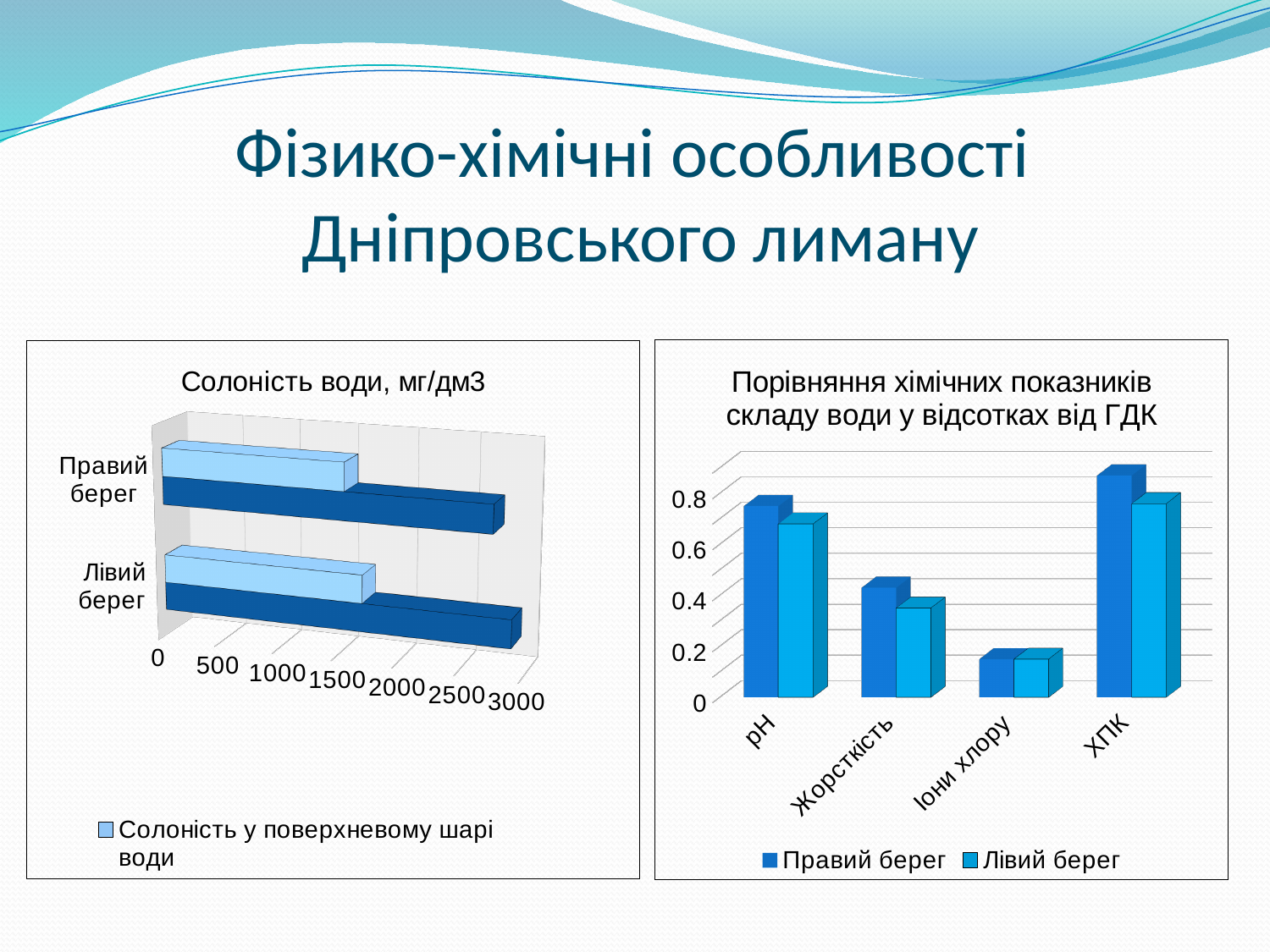
How many series does the legend of the right chart "Порівняння хімічних показників складу води у відсотках від ГДК" list? 2 On the right chart "Порівняння хімічних показників складу води у відсотках від ГДК", is the value of pH for Правий берег greater or less than 0.6? greater On the right chart "Порівняння хімічних показників складу води у відсотках від ГДК", which category has the highest value for Правий берег? ХПК On the left chart "Солоність води, мг/дм3", is the value of "Солоність у поверхневому шарі води" for Лівий берег greater or less than 1000? greater What kind of chart is the right chart "Порівняння хімічних показників складу води у відсотках від ГДК"? bar chart On the right chart "Порівняння хімічних показників складу води у відсотках від ГДК", which category has the lowest value for Лівий берег? Іони хлору On the right chart "Порівняння хімічних показників складу води у відсотках від ГДК", which is larger for ХПК: Правий берег or Лівий берег? Правий берег On the left chart "Солоність води, мг/дм3", is the value of "Солоність у поверхневому шарі води" for Правий берег greater or less than 2000? less On the left chart "Солоність води, мг/дм3", what is the highest value shown on the horizontal axis? 3000 How many categories are shown on the right chart "Порівняння хімічних показників складу води у відсотках від ГДК"? 4 How many categories are shown on the left chart "Солоність води, мг/дм3"? 2 What kind of chart is the left chart titled "Солоність води, мг/дм3"? bar chart